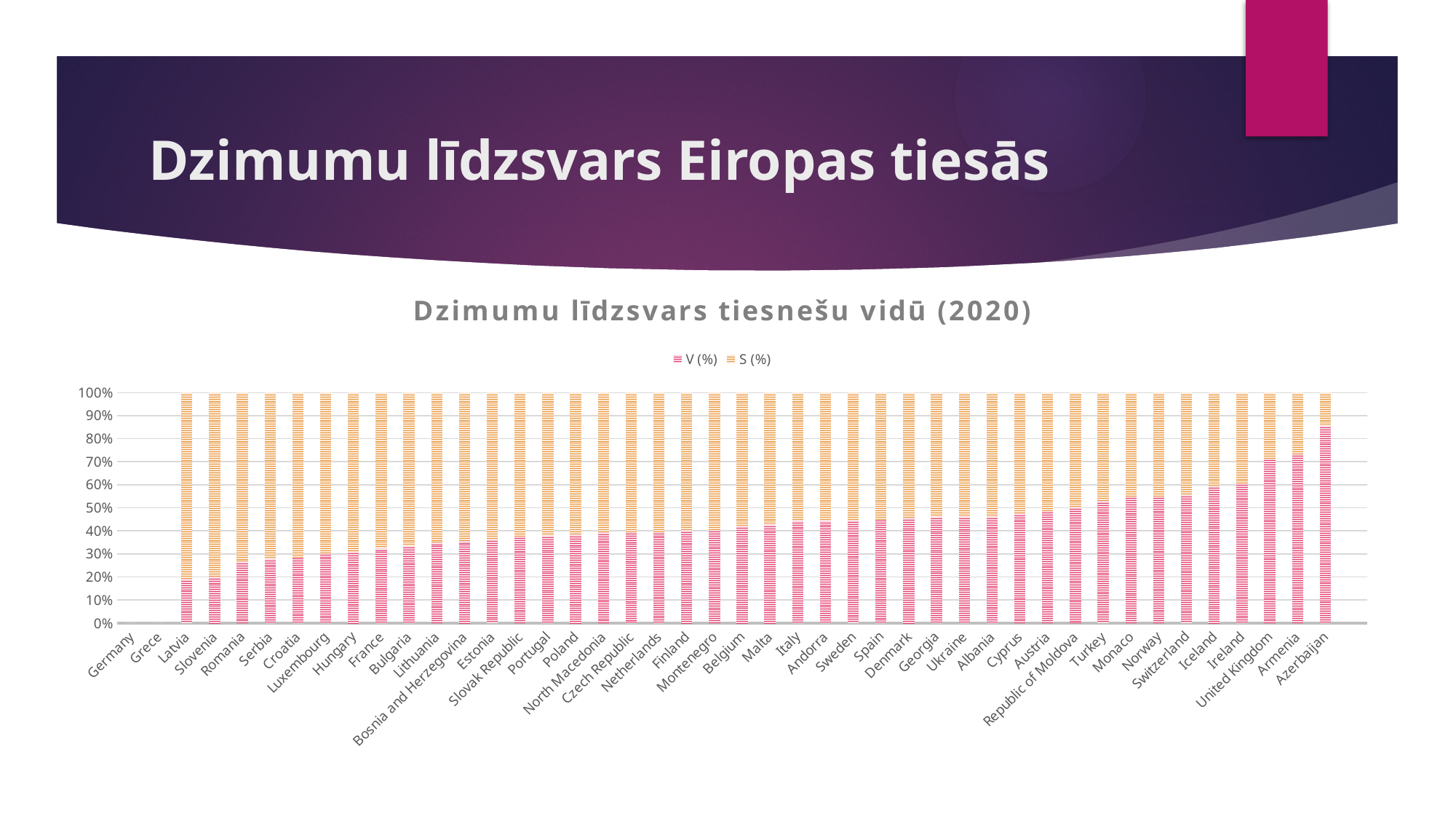
Which has the larger V (%) value, Latvia or Azerbaijan? Azerbaijan Is the V (%) value for United Kingdom greater or less than 60%? greater Is the V (%) value for Italy greater or less than 40%? greater How many countries are listed on the x axis? 44 What type of chart is shown on the slide? Stacked bar chart Which country has the highest V (%) value? Azerbaijan How many series does the legend list? 2 What are the two series named in the legend? V (%) and S (%) Do the V (%) values generally rise or fall moving from left to right along the x axis? rise What is the title of the chart? Dzimumu līdzsvars tiesnešu vidū (2020) Is the V (%) value for Azerbaijan greater or less than 80%? greater